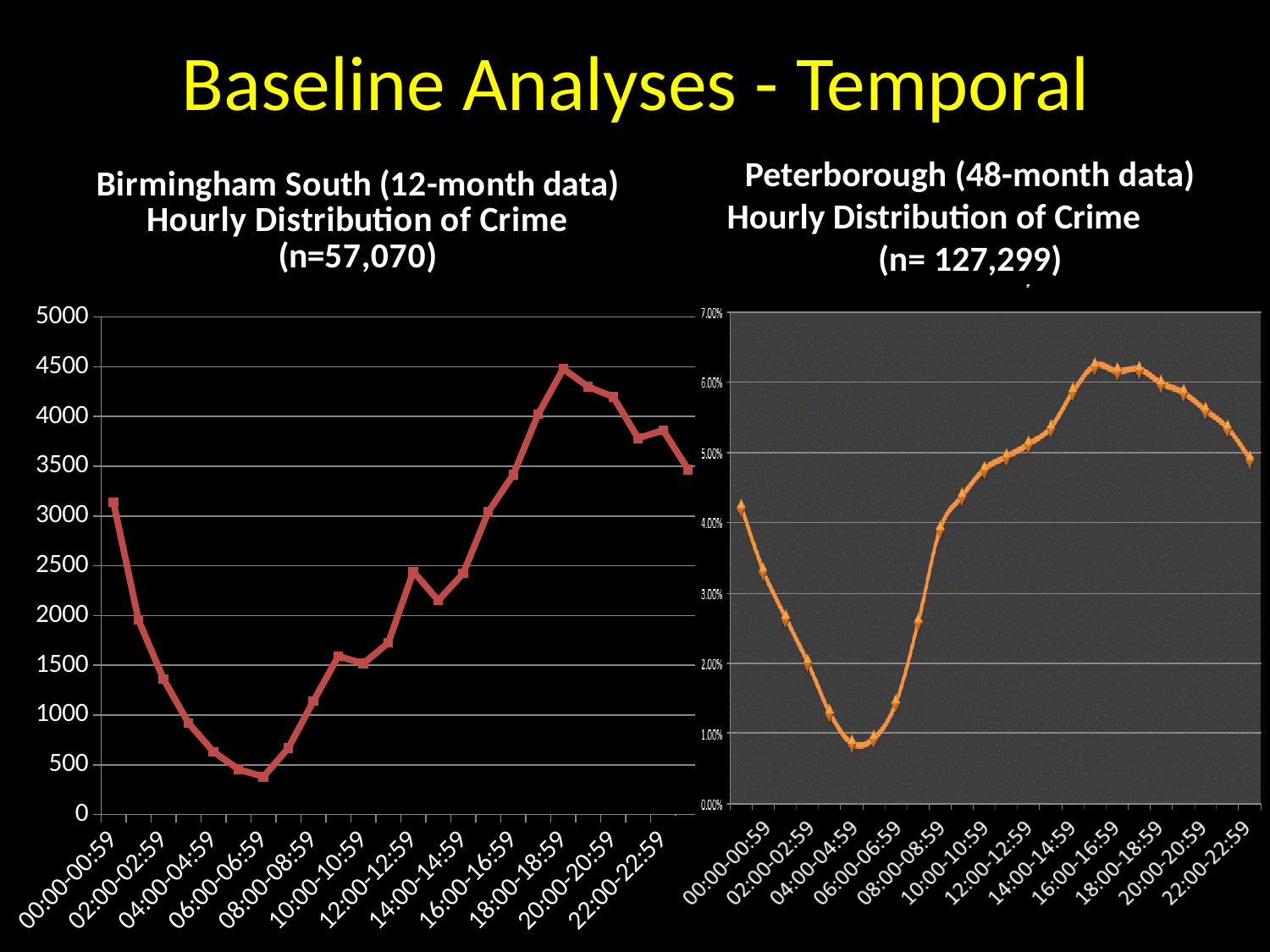
In the Peterborough chart, is the value for 04:00-04:59 greater or less than 2.00%? less In the Birmingham South chart, do the values rise or fall from 08:00-08:59 to 18:00-18:59? rise In the Birmingham South chart, is the value for 18:00-18:59 greater or less than 4000? greater In the Birmingham South chart, is the value for 06:00-06:59 greater or less than 1000? less In the Birmingham South chart, which is larger, the value for 00:00-00:59 or the value for 12:00-12:59? 00:00-00:59 What sample size (n) is given in the title of the Peterborough chart? 127,299 In the Birmingham South chart, which hourly period has the highest value? 18:00-18:59 What kind of chart is the Peterborough chart on the right? line chart What kind of chart is the Birmingham South chart on the left? line chart